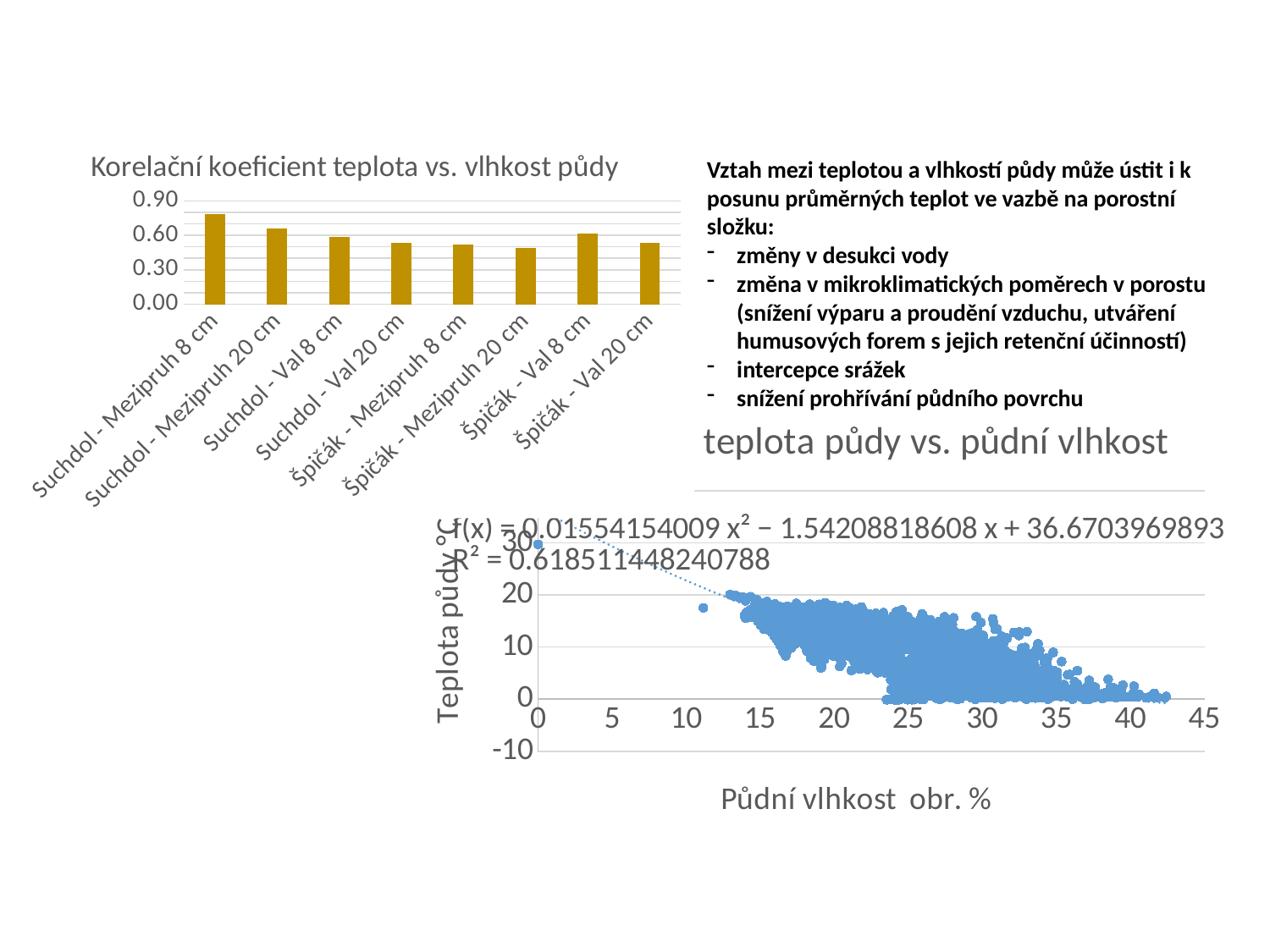
In the chart "Korelační koeficient teplota vs. vlhkost půdy", is the value for Špičák - Mezipruh 20 cm greater or less than 0.60? less In the chart "teplota půdy vs. půdní vlhkost", do the soil temperature values rise or fall as soil moisture increases along the x axis? fall In the chart "Korelační koeficient teplota vs. vlhkost půdy", how many categories are shown? 8 In the chart "Korelační koeficient teplota vs. vlhkost půdy", which is larger: the value for Suchdol - Mezipruh 8 cm or the value for Suchdol - Val 20 cm? Suchdol - Mezipruh 8 cm In the chart "teplota půdy vs. půdní vlhkost", what is the label of the x axis? Půdní vlhkost obr. % What type of chart is the chart titled "Korelační koeficient teplota vs. vlhkost půdy"? bar chart In the chart "teplota půdy vs. půdní vlhkost", what is the R² value shown for the trendline? 0.618511448240788 In the chart "Korelační koeficient teplota vs. vlhkost půdy", which category has the highest value? Suchdol - Mezipruh 8 cm What type of chart is the chart titled "teplota půdy vs. půdní vlhkost"? scatter chart In the chart "Korelační koeficient teplota vs. vlhkost půdy", is the value for Suchdol - Mezipruh 8 cm greater or less than 0.60? greater In the chart "Korelační koeficient teplota vs. vlhkost půdy", is the value for Suchdol - Val 20 cm greater or less than 0.30? greater In the chart "Korelační koeficient teplota vs. vlhkost půdy", which category has the lowest value? Špičák - Mezipruh 20 cm